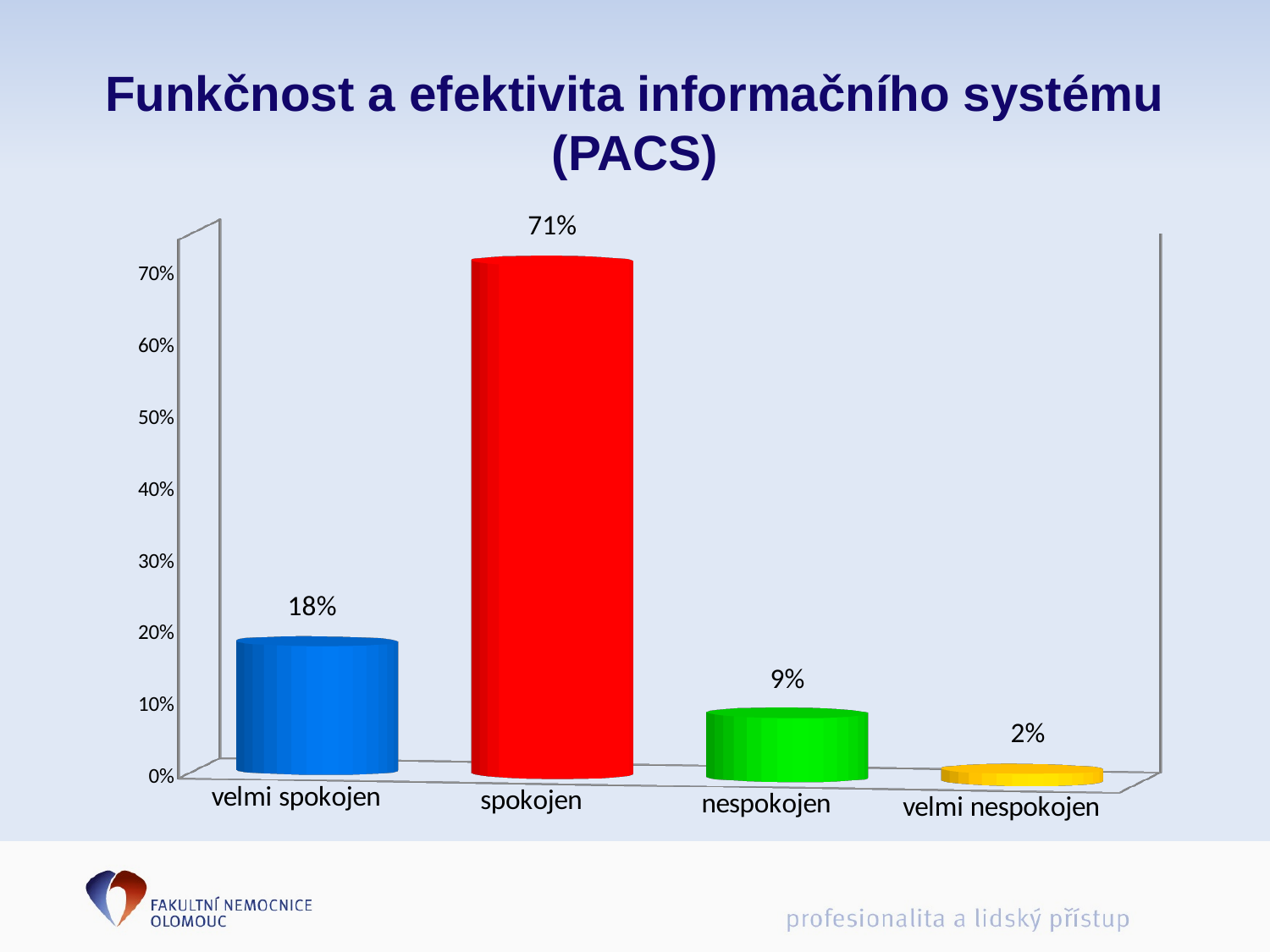
How many categories are shown on the x axis? 4 What is the value for "nespokojen"? 9% Is the value for "velmi spokojen" greater or less than 20%? less What kind of chart is shown on the slide? bar chart What is the value for "spokojen"? 71% What is the difference between the values for "spokojen" and "velmi spokojen"? 53% Which category has the lowest value? velmi nespokojen Which is larger, the value for "velmi spokojen" or the value for "nespokojen"? velmi spokojen What is the value for "velmi spokojen"? 18% What is the difference between the values for "nespokojen" and "velmi nespokojen"? 7% Which category has the highest value? spokojen What is the value for "velmi nespokojen"? 2%